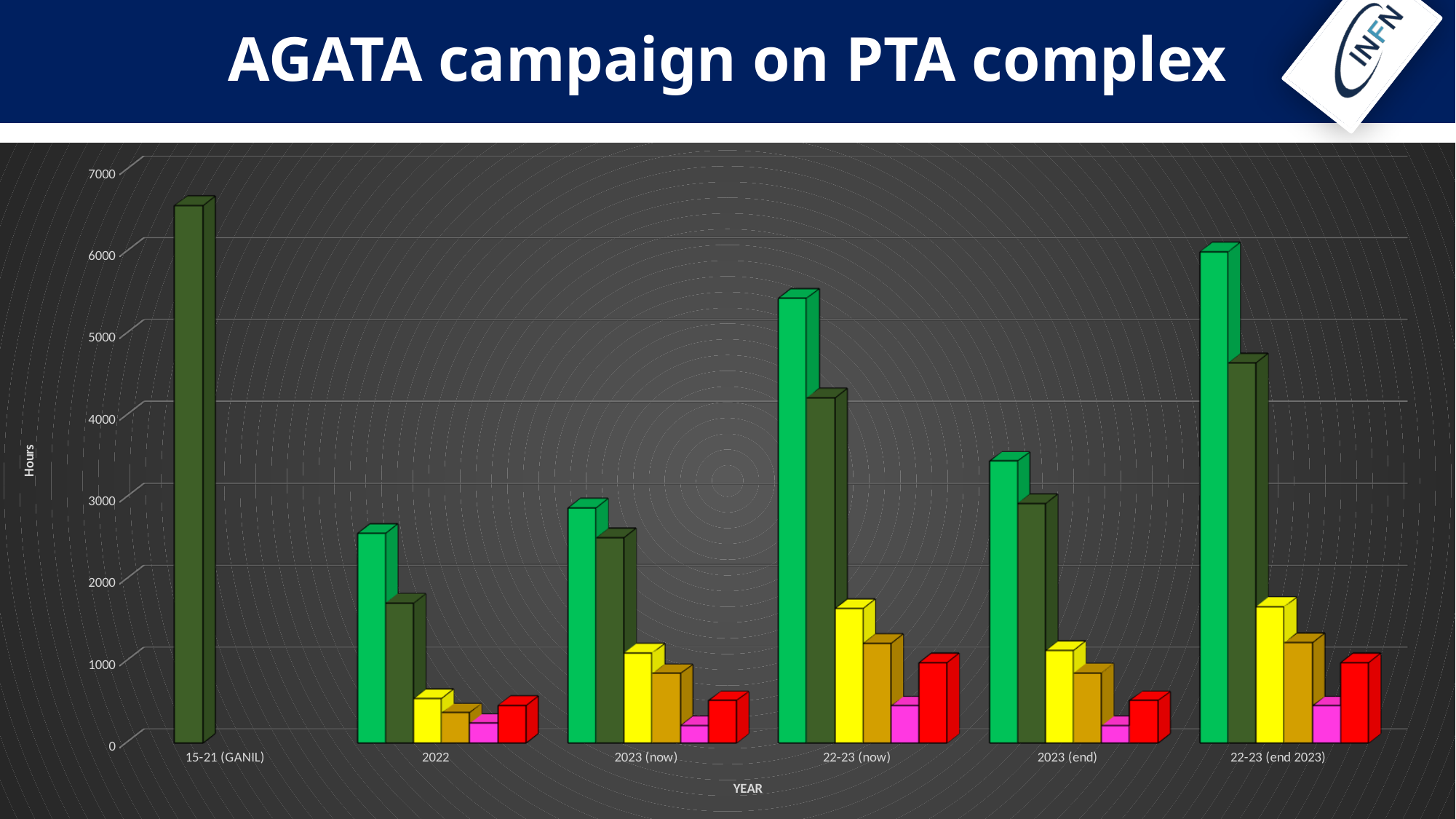
Is the value of the bar for 15-21 (GANIL) greater or less than 6000? greater Is the value of the tallest (bright green) bar for 2022 greater or less than 3000? less Is the value of the tallest bar for 22-23 (end 2023) greater or less than 5000? greater What is the title of the horizontal axis of the chart? YEAR Which category has the taller tallest bar: 22-23 (now) or 22-23 (end 2023)? 22-23 (end 2023) How many categories are shown along the x axis of the chart? 6 What is the title of the vertical axis of the chart? Hours Which category has the tallest bar in the chart? 15-21 (GANIL) What kind of chart is shown on the slide? bar chart How many bars are plotted for the 2022 category? 6